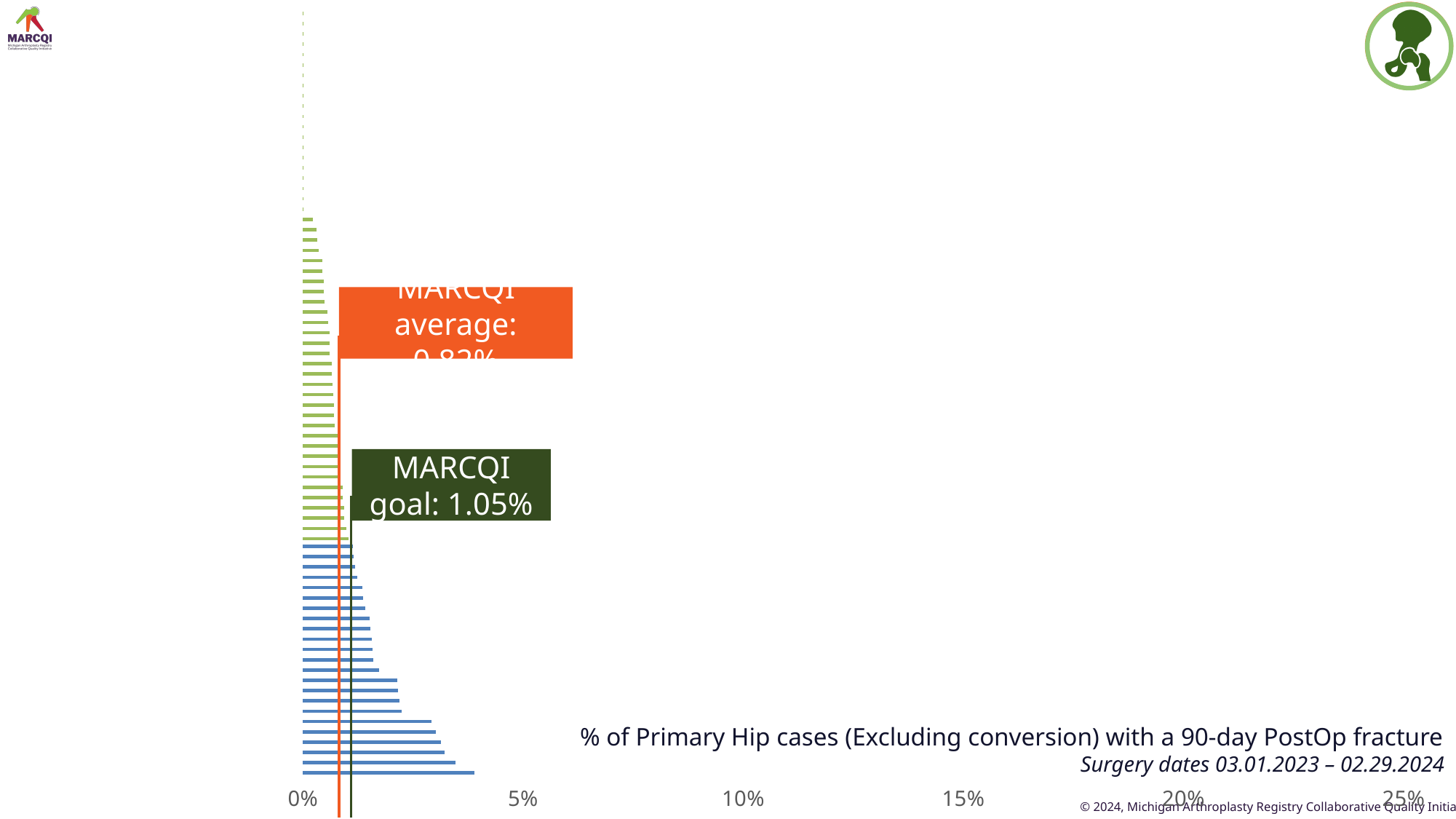
What kind of chart is shown on the slide? bar chart What is the title of the chart? % of Primary Hip cases (Excluding conversion) with a 90-day PostOp fracture What MARCQI goal value is shown on the chart? 1.05% Is the MARCQI goal of 1.05% greater or less than 5%? less What surgery date range does the chart cover? 03.01.2023 – 02.29.2024 Is the longest bar on the chart greater or less than 10%? less Is the longest bar on the chart greater or less than 5%? less What is the highest value shown on the x axis? 25%